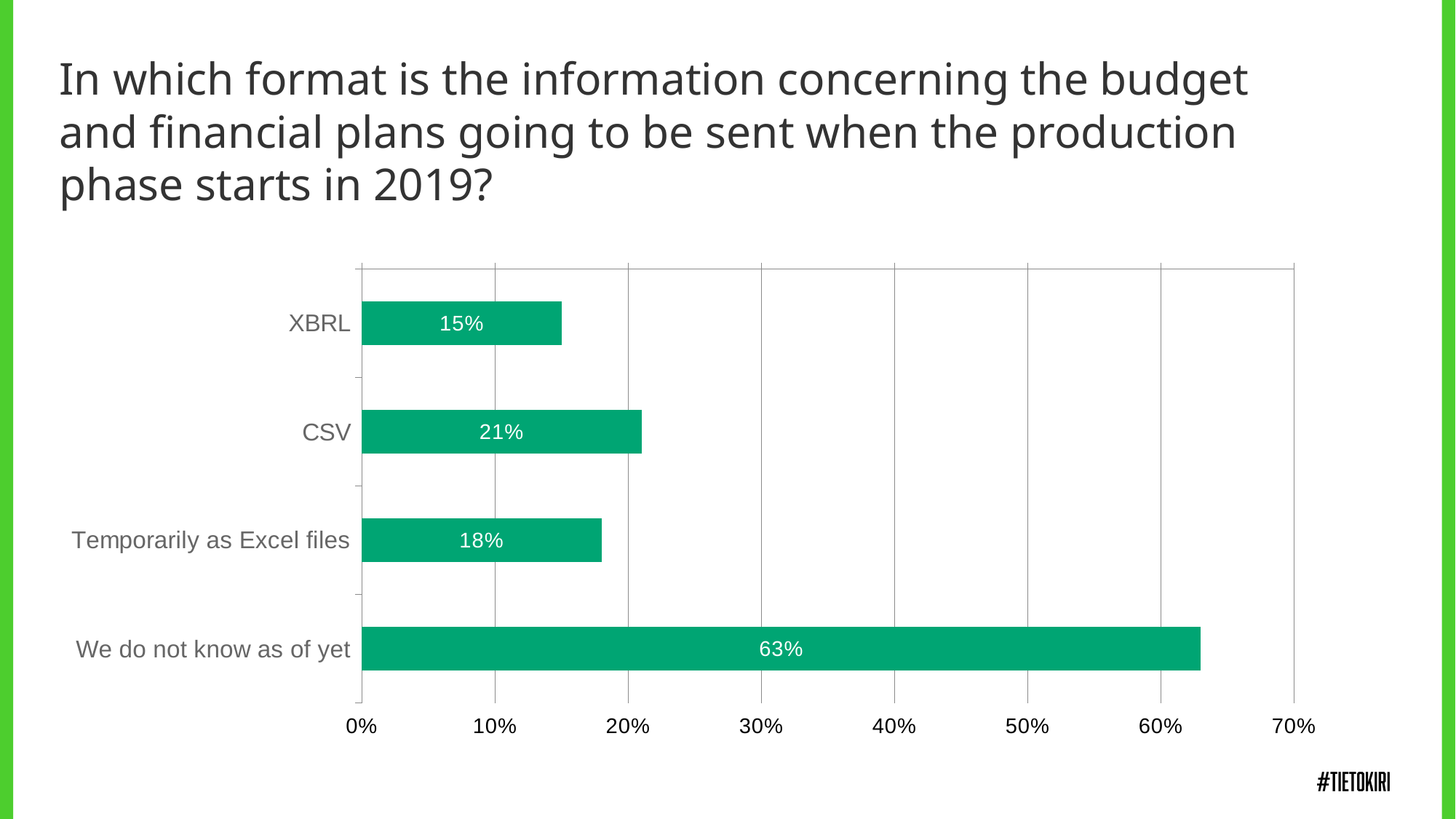
What percentage of respondents chose CSV? 21% What kind of chart is shown on the slide? Bar chart What is the highest value shown on the x axis? 70% Which category has the lowest value? XBRL What is the difference between the values for CSV and XBRL? 6% What percentage of respondents chose XBRL? 15% Which is larger, the value for CSV or the value for 'Temporarily as Excel files'? CSV How many categories are shown in the chart? 4 Which category has the highest value? We do not know as of yet What is the value for 'Temporarily as Excel files'? 18% What is the difference between 'We do not know as of yet' and 'Temporarily as Excel files'? 45% What is the value for 'We do not know as of yet'? 63%